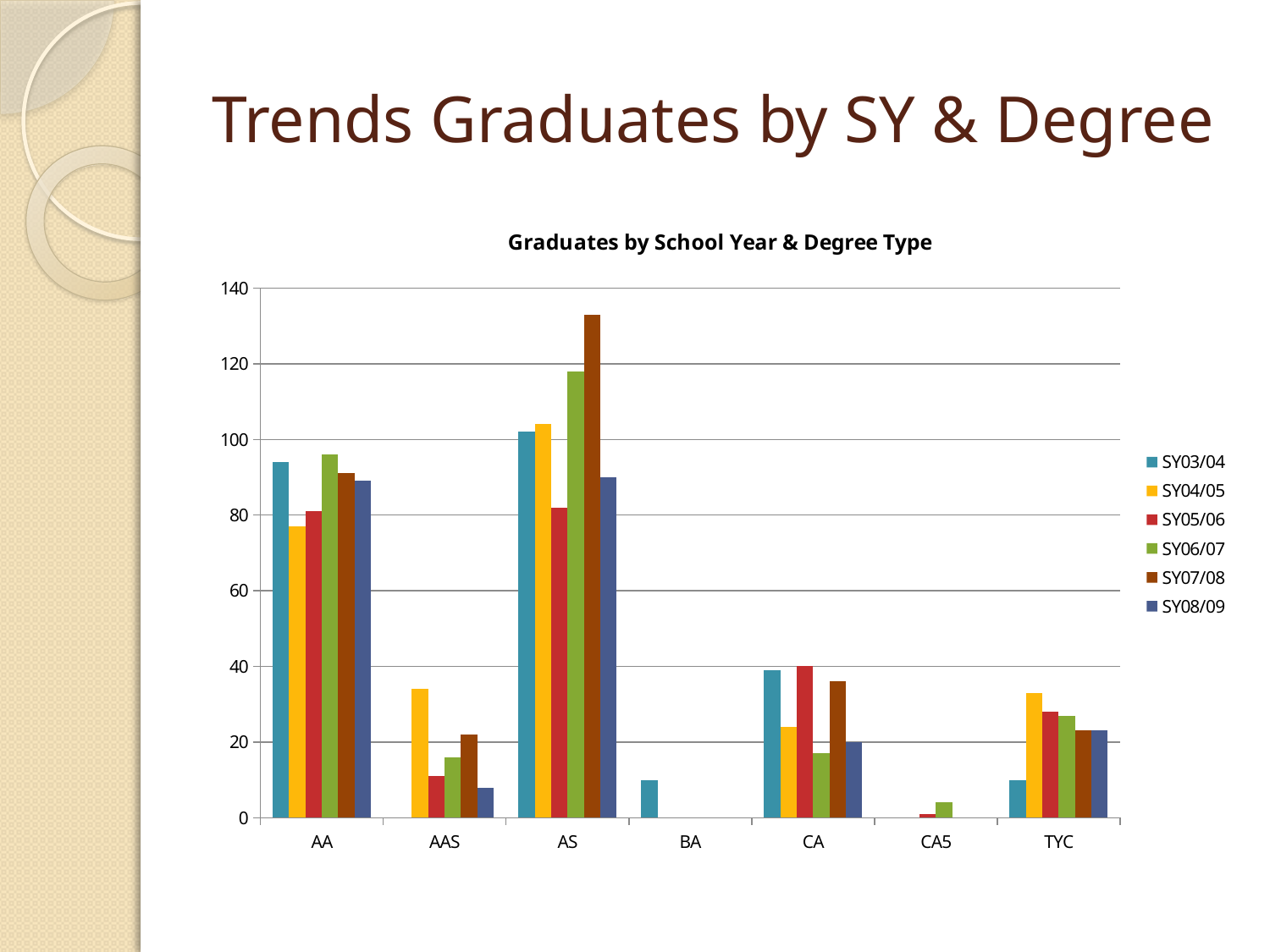
Is the value for TYC in SY04/05 greater or less than 40? less For AS, which is larger: the SY06/07 value or the SY08/09 value? SY06/07 What is the title of the chart? Graduates by School Year & Degree Type Which degree type has the tallest bar in the chart? AS Is the value for AS in SY07/08 greater or less than 120? greater How many series does the legend list? 6 What kind of chart is shown on the slide? bar chart For CA, which is larger: the SY03/04 value or the SY04/05 value? SY03/04 How many degree type categories are shown on the x axis? 7 Which school year is the only series with a visible bar for BA? SY03/04 Is the value for AA in SY03/04 greater or less than 80? greater